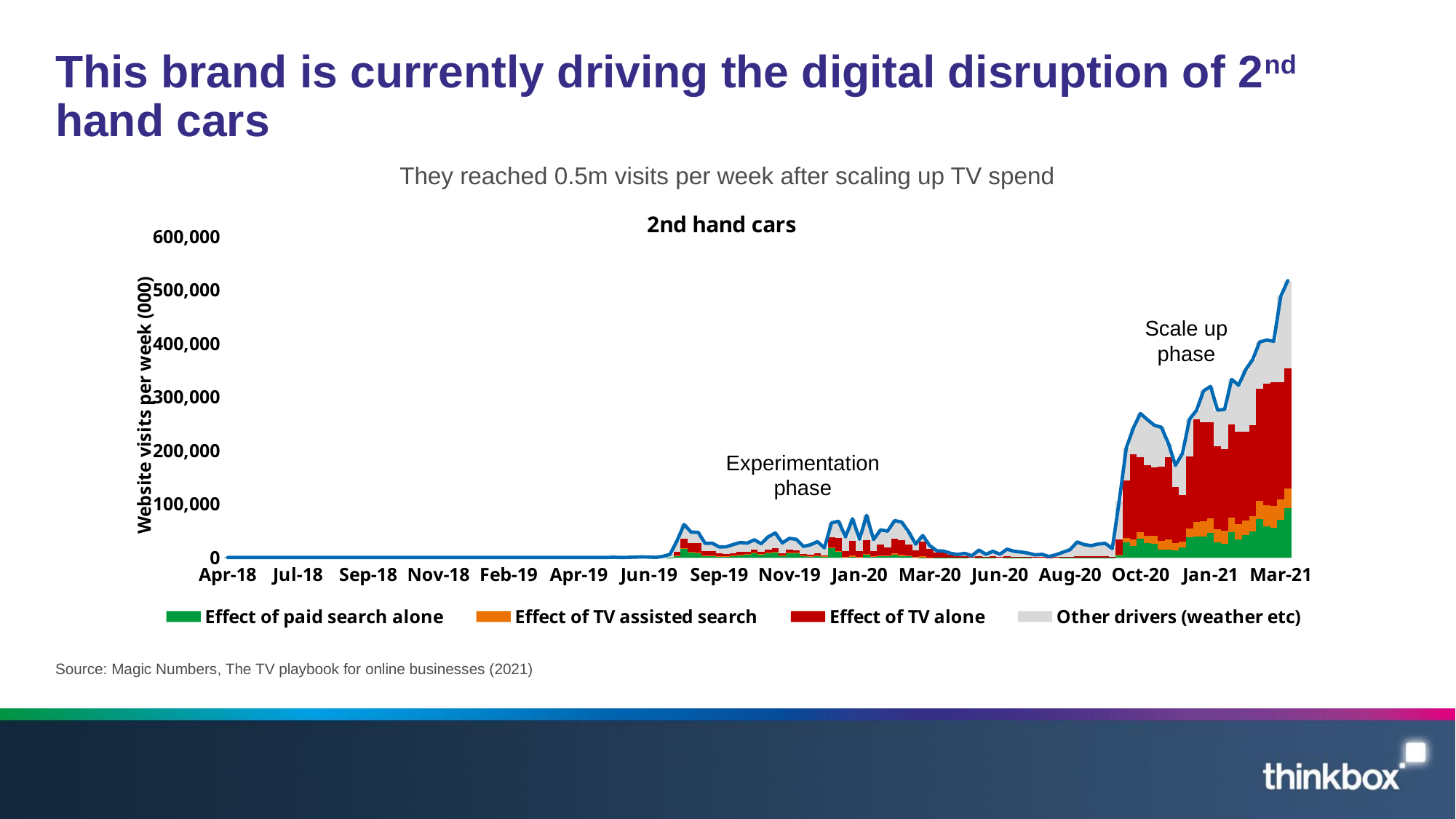
Is the total value at Mar-21 greater or less than 400,000? greater Which series is shown in red? Effect of TV alone What is the title of the chart? 2nd hand cars At which x-axis label does the total reach its highest value? Mar-21 Is the total value at Apr-18 greater or less than 100,000? less What is the label on the vertical axis of the chart? Website visits per week (000) Is the peak total value around Sep-19 greater or less than 100,000? less Do website visits overall rise or fall from Apr-18 to Mar-21? rise Which phase shows higher website visits, the Experimentation phase or the Scale up phase? Scale up phase How many series does the chart legend list? 4